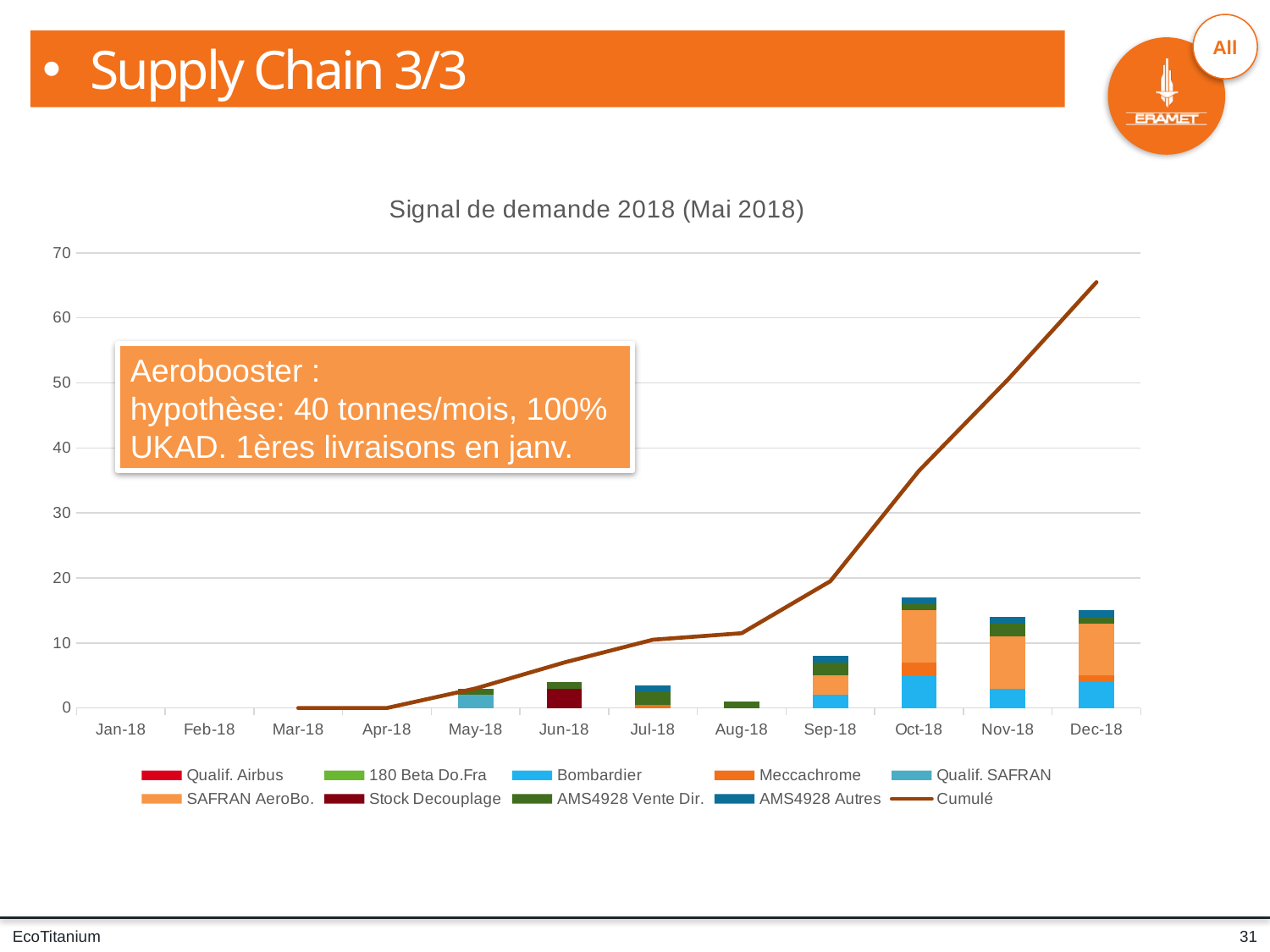
How many series does the legend list? 10 Is the total height of the stacked bar for Oct-18 greater or less than 20? less Is the Cumulé value for Dec-18 greater or less than 60? greater Is the Cumulé value for Oct-18 greater or less than 30? greater Which stacked bar is taller, Sep-18 or Oct-18? Oct-18 Which series is plotted as a line rather than as bars? Cumulé How many months are shown on the x axis of the chart? 12 What is the title of the chart? Signal de demande 2018 (Mai 2018) Which month has the tallest stacked bar? Oct-18 What kind of chart is shown on the slide? A combined stacked bar and line chart Does the Cumulé line rise or fall from Mar-18 to Dec-18? Rises